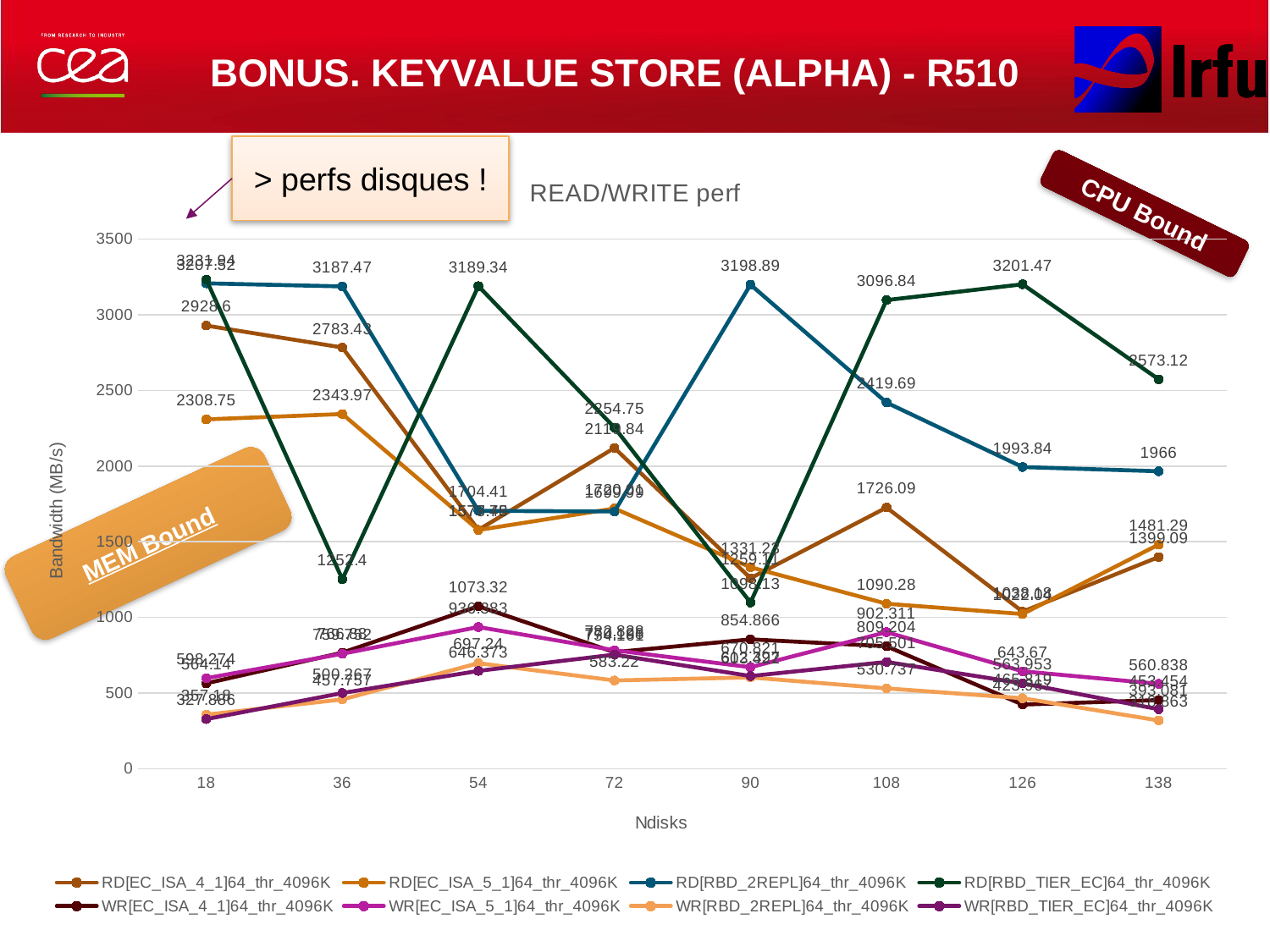
What is the value of WR[EC_ISA_4_1]64_thr_4096K at 54 disks? 1073.32 What is the value of RD[RBD_TIER_EC]64_thr_4096K at 126 disks? 3201.47 How many series does the legend of the READ/WRITE perf chart list? 8 How many Ndisks values are plotted along the x axis of the READ/WRITE perf chart? 8 What kind of chart is shown on the slide? line chart What is the value of RD[RBD_2REPL]64_thr_4096K at 138 disks? 1966 Is the value of WR[EC_ISA_5_1]64_thr_4096K at 138 disks greater or less than 1000? less What is the value of RD[RBD_2REPL]64_thr_4096K at 36 disks? 3187.47 What is the value of RD[EC_ISA_4_1]64_thr_4096K at 18 disks? 2928.6 Which is larger for RD[RBD_2REPL]64_thr_4096K: the value at 36 disks or at 138 disks? 36 disks What is the difference between the RD[RBD_TIER_EC]64_thr_4096K values at 126 disks and 138 disks? 628.35 What is the label of the y axis of the READ/WRITE perf chart? Bandwidth (MB/s)